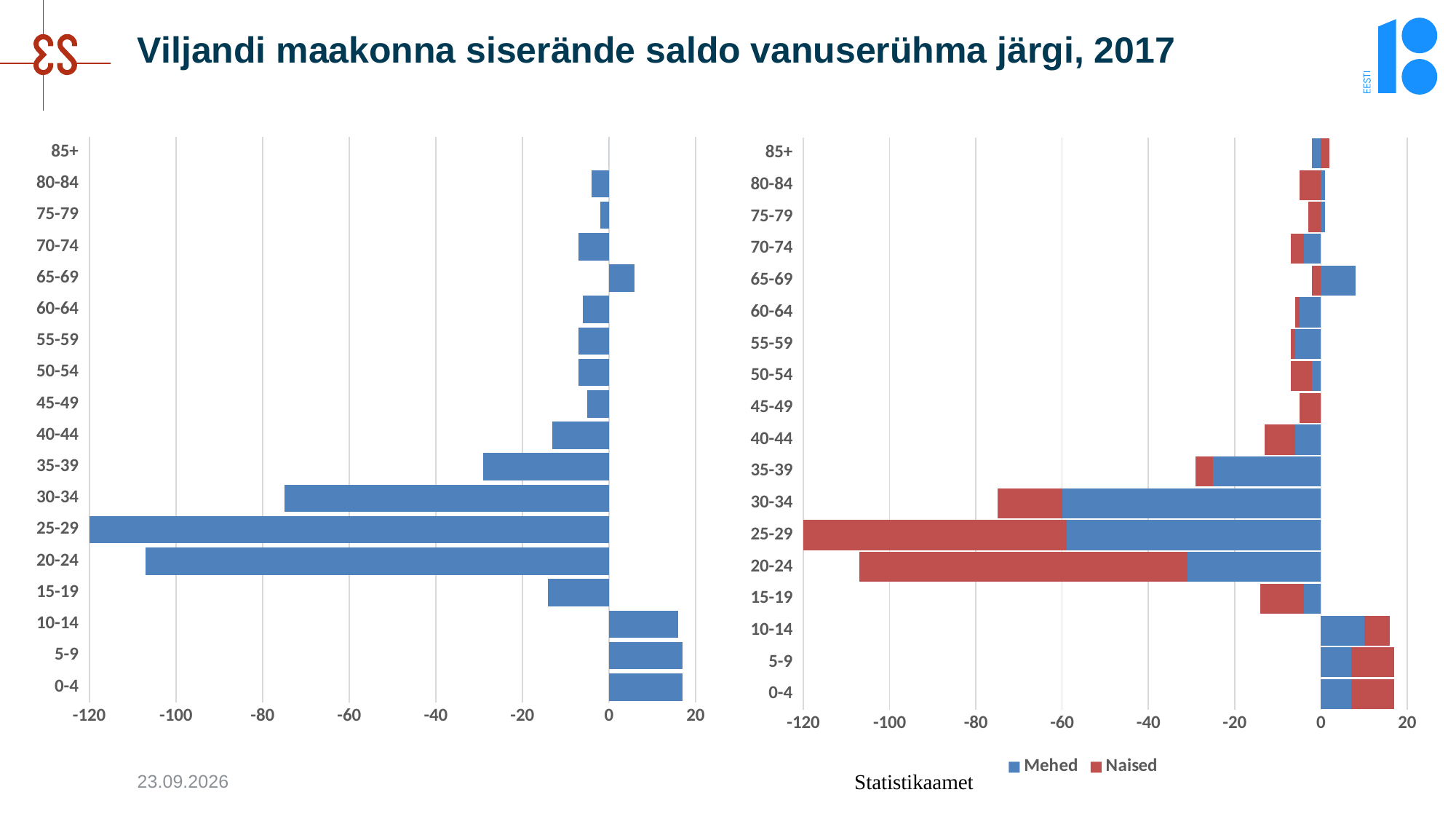
What kind of chart is the left chart on the slide? bar chart On the right chart, for the 20-24 age group, which series has the larger negative segment, Mehed or Naised? Naised On the left chart, is the value for 65-69 greater or less than 0? greater What are the two legend entries of the right chart? Mehed, Naised How many age groups are shown on the left chart? 18 On the left chart, which age group has the lower value, 35-39 or 40-44? 35-39 On the left chart, which age group has the lowest (most negative) value? 25-29 On the left chart, is the value for 30-34 greater or less than -60? less On the left chart, is the value for 20-24 greater or less than -100? less On the right chart, for the 30-34 age group, which series has the larger negative segment, Mehed or Naised? Mehed How many series does the legend of the right chart list? 2